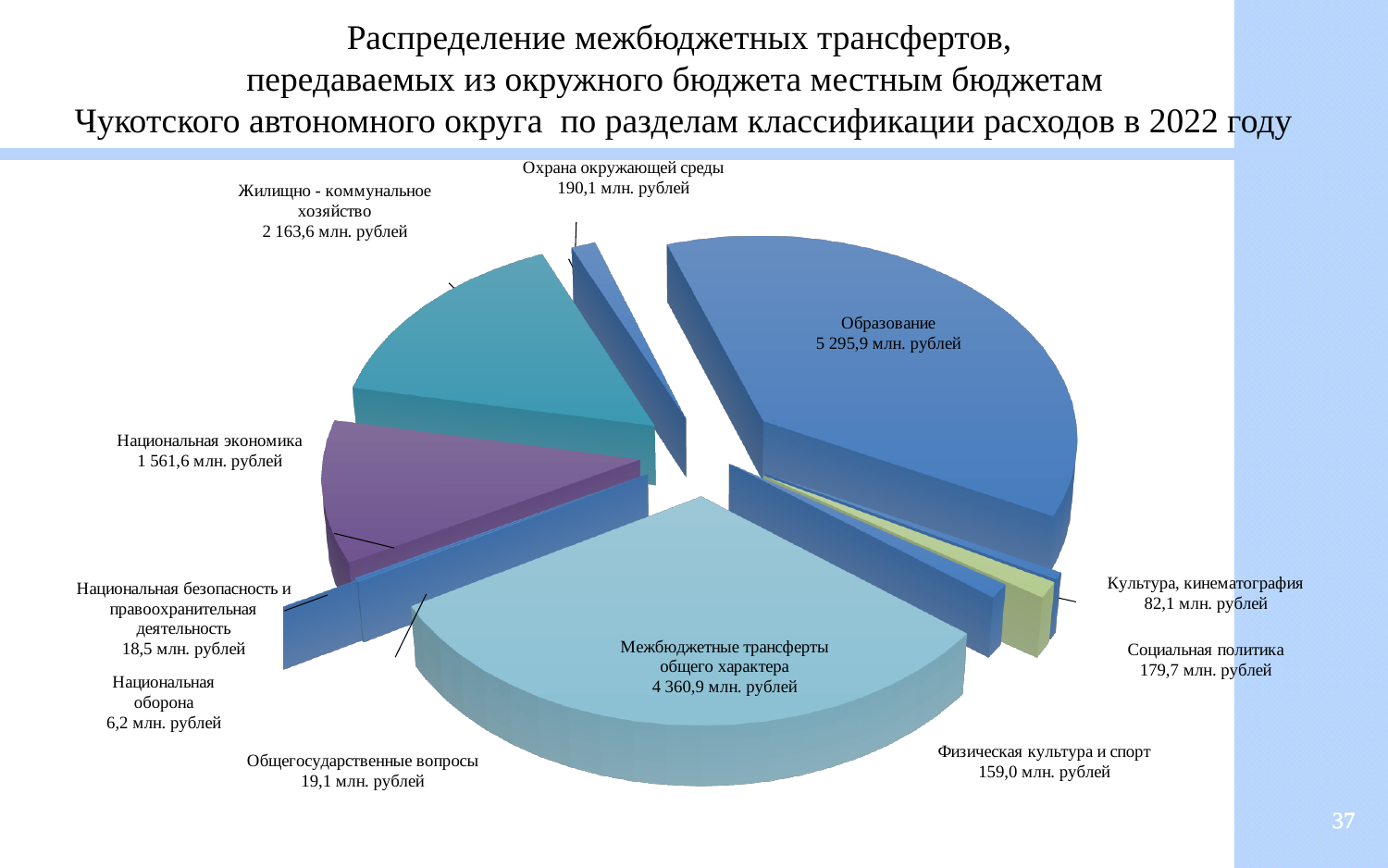
What kind of chart is shown on the slide? Pie chart What is the value for Образование? 5 295,9 млн. рублей What is the value for Межбюджетные трансферты общего характера? 4 360,9 млн. рублей How many categories (slices) does the pie chart have? 11 What is the difference between Охрана окружающей среды and Социальная политика? 10,4 млн. рублей Which is larger: Жилищно-коммунальное хозяйство or Национальная экономика? Жилищно-коммунальное хозяйство Which is larger: Социальная политика or Физическая культура и спорт? Социальная политика What is the difference between Образование and Межбюджетные трансферты общего характера? 935,0 млн. рублей What is the value for Культура, кинематография? 82,1 млн. рублей What is the value for Национальная экономика? 1 561,6 млн. рублей Which category has the smallest value? Национальная оборона Which category has the largest value? Образование